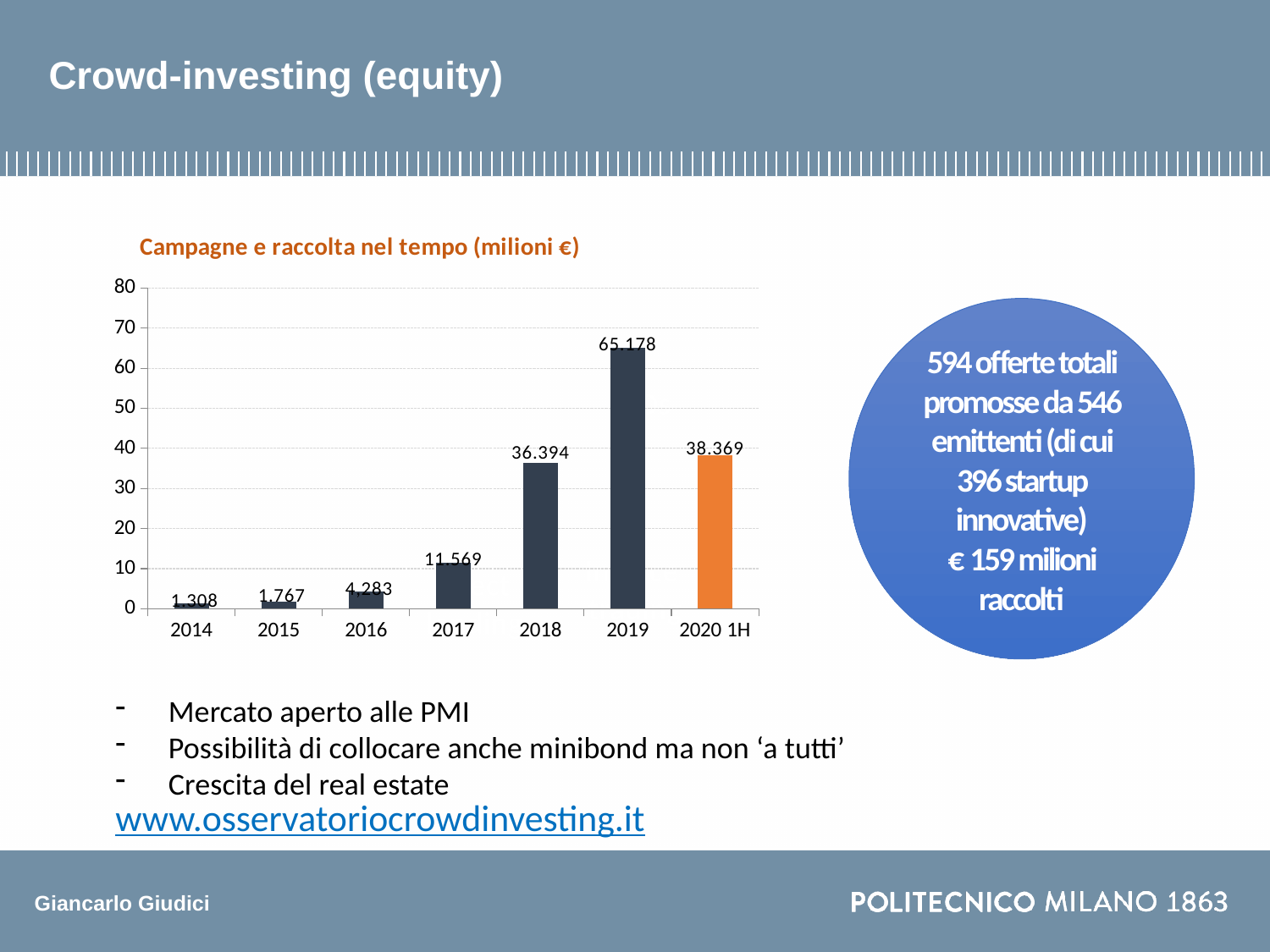
Which category has the lowest value? 2014 What is the difference between the values for 2019 and 2018? 28.784 What is the title of the chart? Campagne e raccolta nel tempo (milioni €) Which is larger, the value for 2020 1H or the value for 2018? 2020 1H How many categories are shown on the x axis? 7 What kind of chart is shown on the slide? bar chart What is the value for 2020 1H? 38.369 What is the value for 2019? 65.178 Is the value for 2019 greater or less than 60? greater What is the value for 2018? 36.394 What is the value for 2017? 11.569 Which year has the highest value? 2019